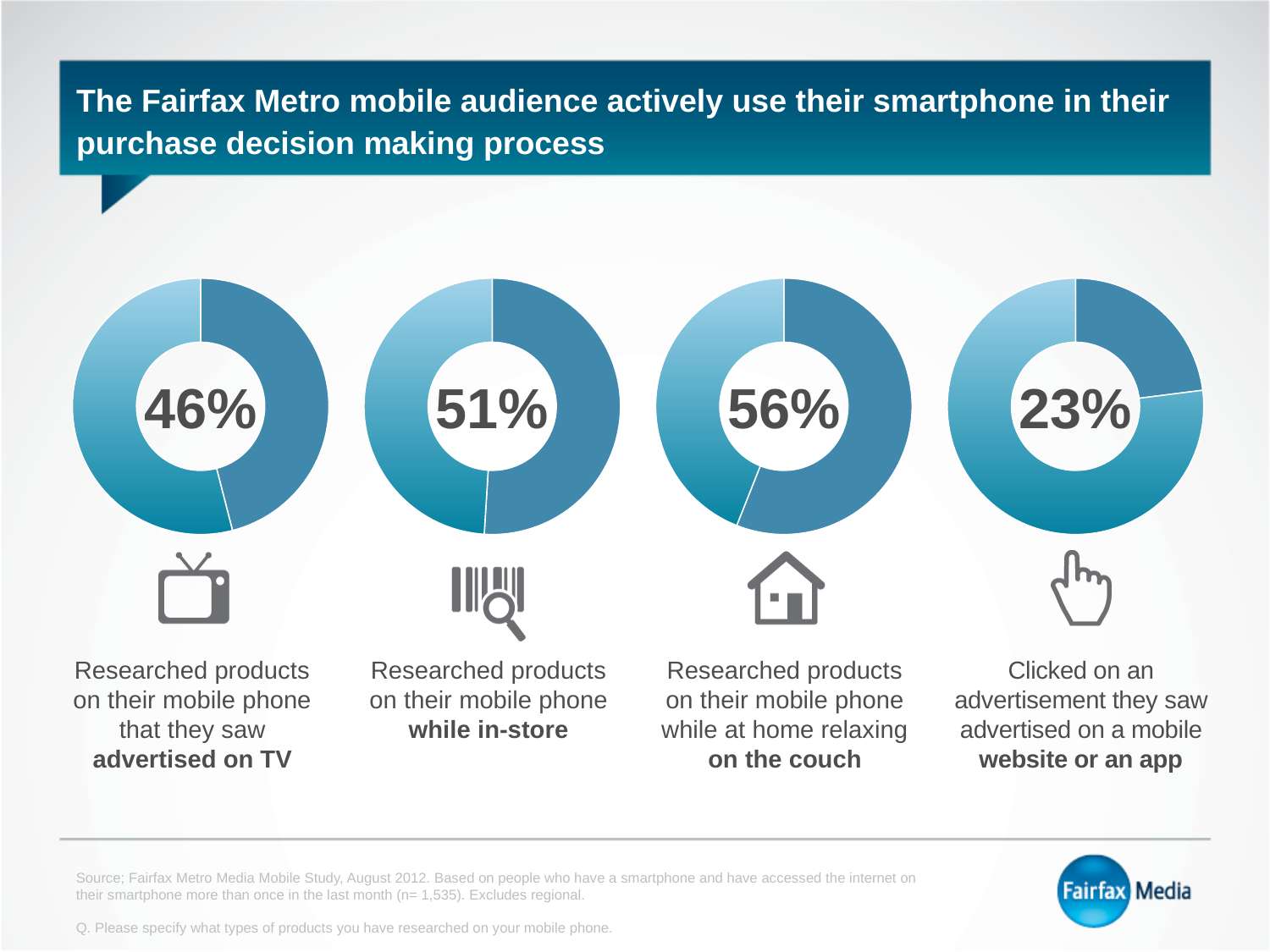
Which of the four behaviours shown has the highest percentage? Researched products on their mobile phone while at home relaxing on the couch What is the sample size (n) stated in the source note on the slide? 1,535 What is the difference in percentage points between researching products while in-store and clicking on a mobile website or app advertisement? 28 What is the difference in percentage points between researching products while on the couch and researching products seen advertised on TV? 10 What percentage of the Fairfax Metro mobile audience researched products on their mobile phone that they saw advertised on TV? 46% What kind of chart is used to display each percentage on the slide? Donut chart What percentage clicked on an advertisement they saw advertised on a mobile website or an app? 23% Which of the four behaviours shown has the lowest percentage? Clicked on an advertisement they saw advertised on a mobile website or an app What percentage researched products on their mobile phone while in-store? 51% Which is larger: the percentage who researched products while in-store or the percentage who researched products they saw advertised on TV? While in-store How many donut charts are shown on the slide? 4 What percentage researched products on their mobile phone while at home relaxing on the couch? 56%